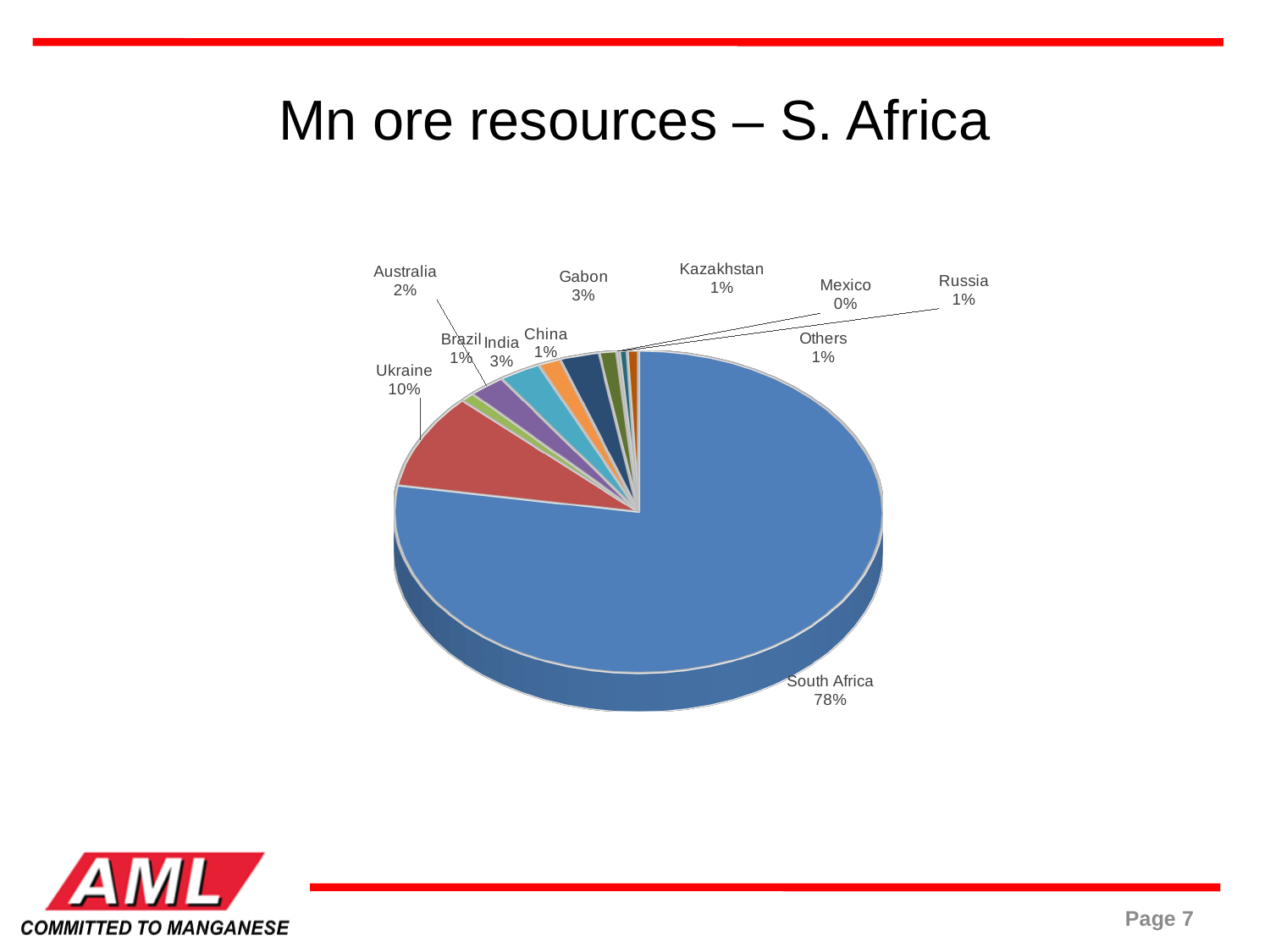
How many slices (categories) does the pie chart have? 11 What kind of chart is shown on the slide? Pie chart What share of Mn ore resources does Ukraine hold? 10% What share is shown for Gabon? 3% What is the title of the slide containing the pie chart? Mn ore resources – S. Africa Which has a larger share, India or Australia? India Which category has the smallest share shown? Mexico What share is shown for Australia? 2% Which country has the largest slice of the pie? South Africa What share is shown for Mexico? 0% What is the difference between South Africa's share and Ukraine's share? 68% What share of Mn ore resources does South Africa hold? 78%